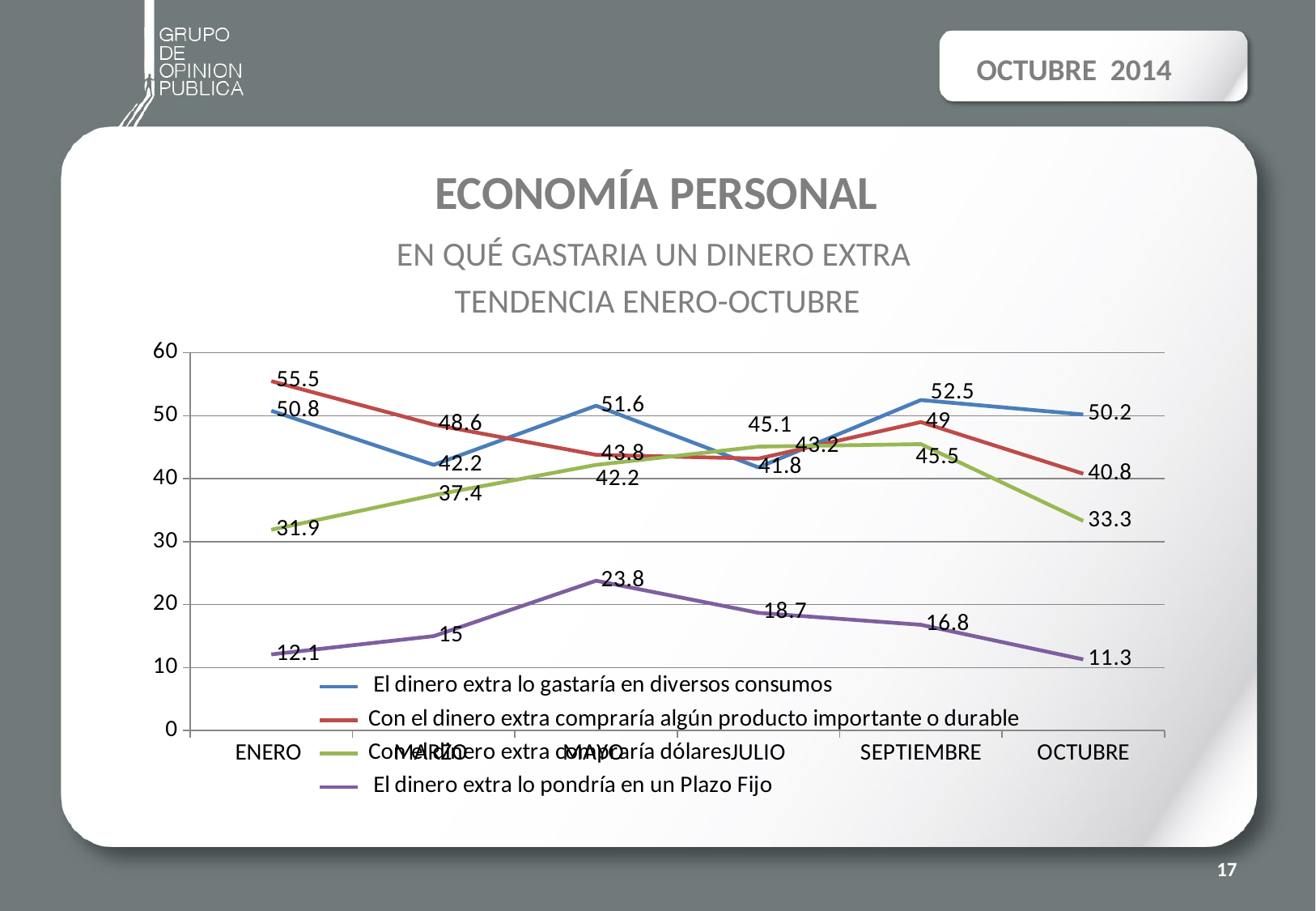
Does the value for 'El dinero extra lo pondría en un Plazo Fijo' rise or fall from MAYO to OCTUBRE? Fall In which month is the value for 'Con el dinero extra compraría algún producto importante o durable' highest? ENERO In which month is the value for 'El dinero extra lo pondría en un Plazo Fijo' lowest? OCTUBRE How many months are shown on the x axis of the chart? 6 How many series does the chart's legend list? 4 In SEPTIEMBRE, which series has the larger value: 'El dinero extra lo gastaría en diversos consumos' or 'Con el dinero extra compraría algún producto importante o durable'? El dinero extra lo gastaría en diversos consumos What value does the series 'El dinero extra lo gastaría en diversos consumos' have in ENERO? 50.8 By how much did the value for 'Con el dinero extra compraría algún producto importante o durable' fall from ENERO to OCTUBRE? 14.7 In which month is the value for 'El dinero extra lo pondría en un Plazo Fijo' highest? MAYO What value does the series 'Con el dinero extra compraría algún producto importante o durable' have in OCTUBRE? 40.8 What kind of chart is shown on the slide? Line chart What value does the series 'El dinero extra lo pondría en un Plazo Fijo' have in MAYO? 23.8